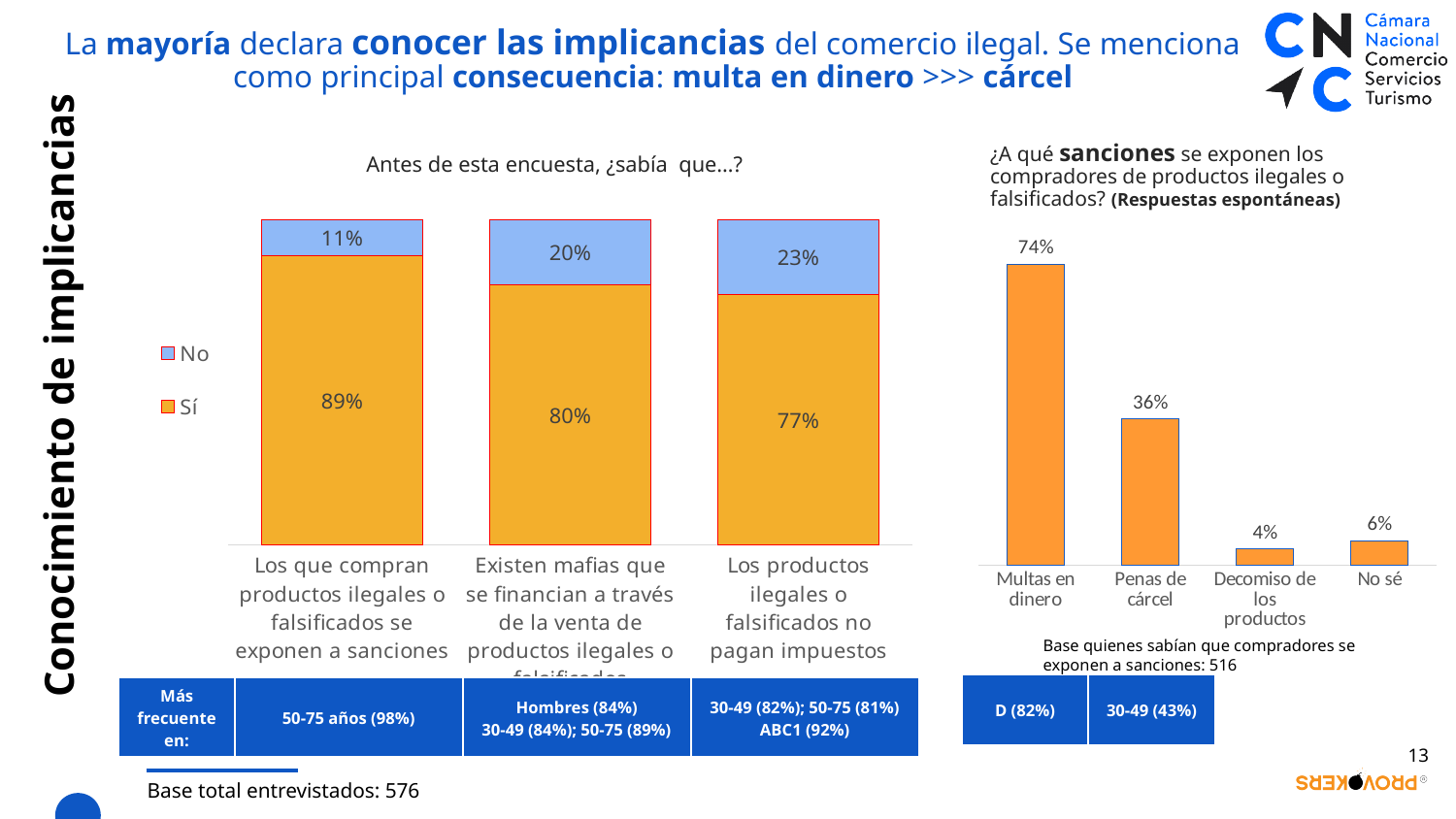
In the left chart 'Antes de esta encuesta, ¿sabía que...?', what is the difference between the 'Sí' values for 'Los que compran productos ilegales o falsificados se exponen a sanciones' and 'Existen mafias que se financian a través de la venta de productos ilegales o falsificados'? 9% In the left chart 'Antes de esta encuesta, ¿sabía que...?', what is the 'No' value for 'Los productos ilegales o falsificados no pagan impuestos'? 23% In the left chart 'Antes de esta encuesta, ¿sabía que...?', what is the total of the stacked bar for 'Existen mafias que se financian a través de la venta de productos ilegales o falsificados'? 100% In the right chart '¿A qué sanciones se exponen los compradores de productos ilegales o falsificados?', what is the value for 'Penas de cárcel'? 36% In the right chart '¿A qué sanciones se exponen los compradores de productos ilegales o falsificados?', how many categories are shown? 4 What kind of chart is the left chart 'Antes de esta encuesta, ¿sabía que...?'? Stacked bar chart In the right chart '¿A qué sanciones se exponen los compradores de productos ilegales o falsificados?', which category has the highest value? Multas en dinero In the left chart 'Antes de esta encuesta, ¿sabía que...?', which category has the lowest 'Sí' value? Los productos ilegales o falsificados no pagan impuestos In the left chart 'Antes de esta encuesta, ¿sabía que...?', what is the 'Sí' value for 'Los que compran productos ilegales o falsificados se exponen a sanciones'? 89% In the left chart 'Antes de esta encuesta, ¿sabía que...?', how many series does the legend list? 2 In the right chart '¿A qué sanciones se exponen los compradores de productos ilegales o falsificados?', what is the difference between 'Multas en dinero' and 'Penas de cárcel'? 38% In the right chart '¿A qué sanciones se exponen los compradores de productos ilegales o falsificados?', which category has the lowest value? Decomiso de los productos